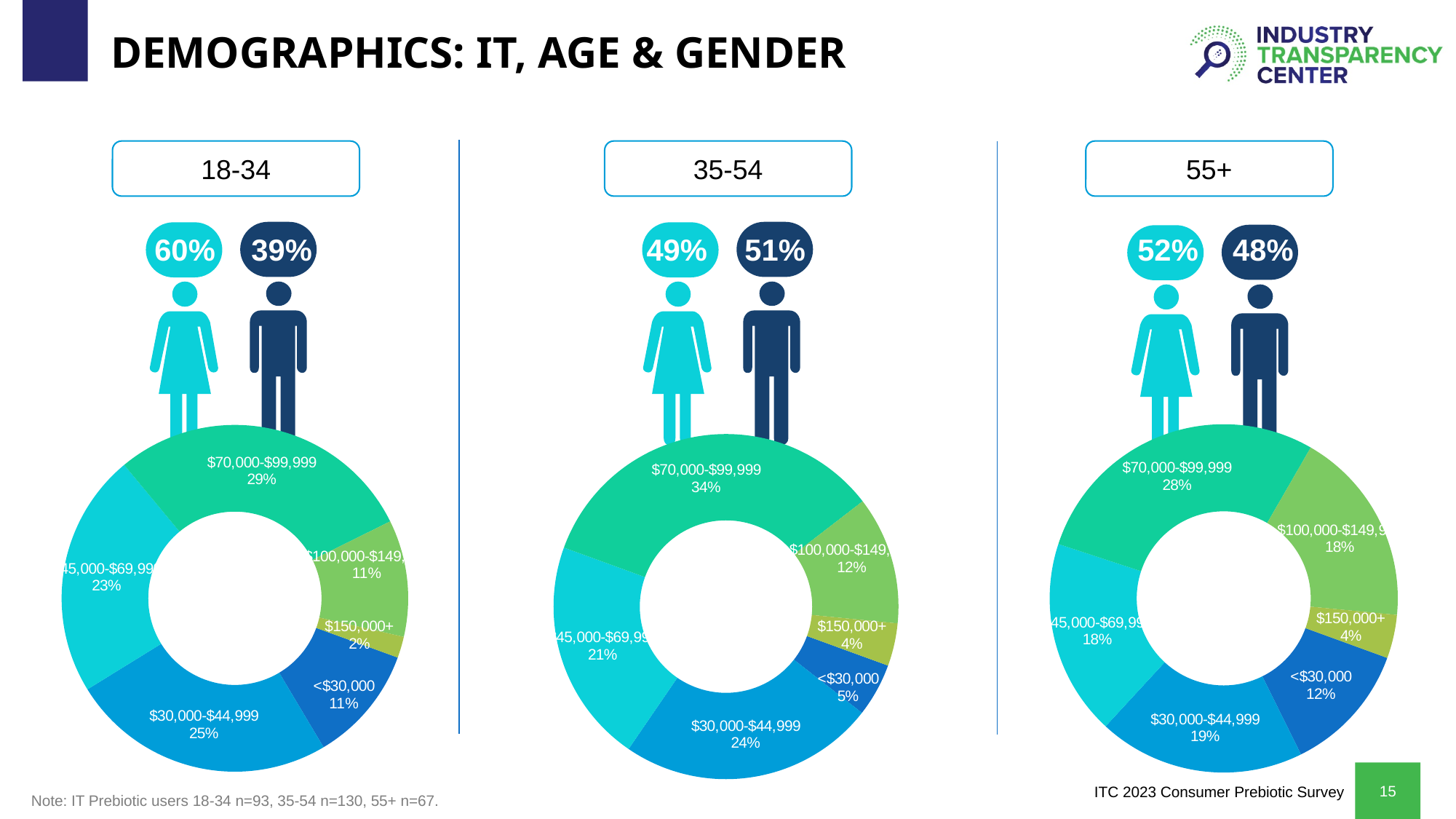
In the 18-34 group, what percentage of respondents are female? 60% In the 55+ donut chart, what is the difference between the $70,000-$99,999 share and the $30,000-$44,999 share? 9 percentage points How many donut charts are on the slide? 3 In the 35-54 group, what percentage of respondents are male? 51% How many income brackets are shown in each donut chart? 6 In the 35-54 donut chart, which income bracket has the largest share? $70,000-$99,999 In the 18-34 donut chart, which income bracket has the smallest share? $150,000+ In the 55+ donut chart, what share of respondents earn less than $30,000? 12% In the 35-54 donut chart, what share of respondents earn $30,000-$44,999? 24% What type of chart is used to show the income distribution for each age group? Donut (pie) chart In the 18-34 donut chart, what share of respondents earn $70,000-$99,999? 29% In the 35-54 donut chart, which is larger: the $150,000+ share or the <$30,000 share? <$30,000